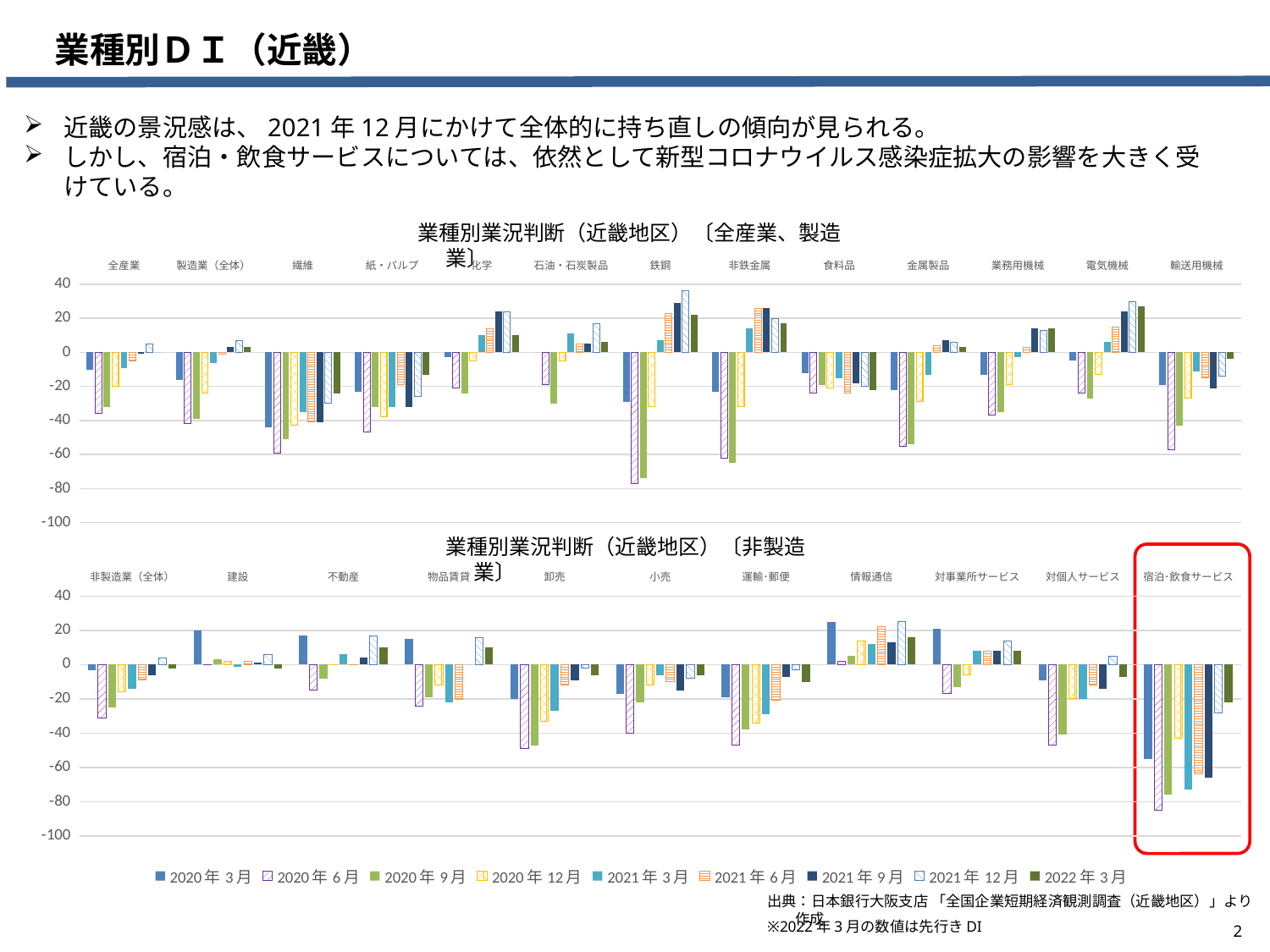
On the bottom chart 業種別業況判断（近畿地区）〔非製造業〕, which category has the lowest bar? 宿泊・飲食サービス How many industry categories are shown on the bottom chart 業種別業況判断（近畿地区）〔非製造業〕? 11 On the bottom chart 業種別業況判断（近畿地区）〔非製造業〕, is the 2020年6月 value for 宿泊・飲食サービス greater or less than -80? less On the top chart 業種別業況判断（近畿地区）〔全産業、製造業〕, which category has the lowest bar? 鉄鋼 On the top chart 業種別業況判断（近畿地区）〔全産業、製造業〕, do the values for 全産業 rise or fall from 2020年6月 to 2021年12月? rise On the bottom chart 業種別業況判断（近畿地区）〔非製造業〕, which category is outlined with a red box? 宿泊・飲食サービス What kind of chart is the top chart titled 業種別業況判断（近畿地区）〔全産業、製造業〕? bar chart How many industry categories are shown on the top chart 業種別業況判断（近畿地区）〔全産業、製造業〕? 13 On the top chart 業種別業況判断（近畿地区）〔全産業、製造業〕, is the 2020年6月 value for 鉄鋼 greater or less than -60? less How many series does the legend at the bottom of the slide list? 9 On the bottom chart 業種別業況判断（近畿地区）〔非製造業〕, is the 2020年3月 value for 情報通信 greater or less than 0? greater On the top chart 業種別業況判断（近畿地区）〔全産業、製造業〕, which is lower for 2020年6月: 鉄鋼 or 繊維? 鉄鋼